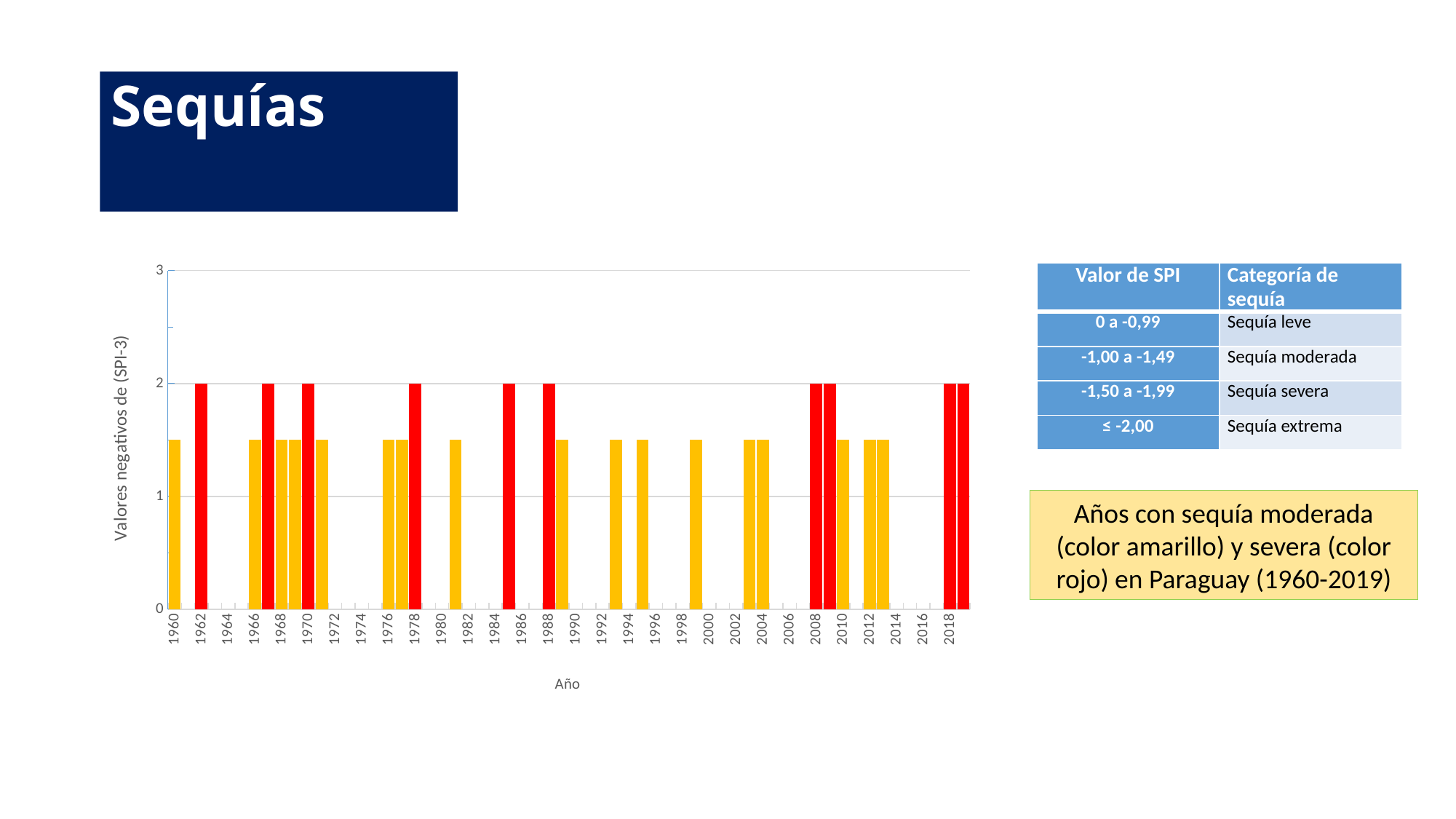
Is the value for 2012 greater or less than 2? less What is the title of the y axis of the chart? Valores negativos de (SPI-3) What is the value of the bar for 1962? 2 Is the value for 1960 greater or less than 1? greater What is the title of the x axis of the chart? Año Which year has the larger value, 1960 or 1962? 1962 What kind of chart is shown on the slide? bar chart Is the value for 1960 greater or less than 2? less What is the value of the bar for 1988? 2 Which year has the larger value, 1970 or 1971? 1970 What is the highest value reached by any bar in the chart? 2 What is the value of the bar for 2008? 2